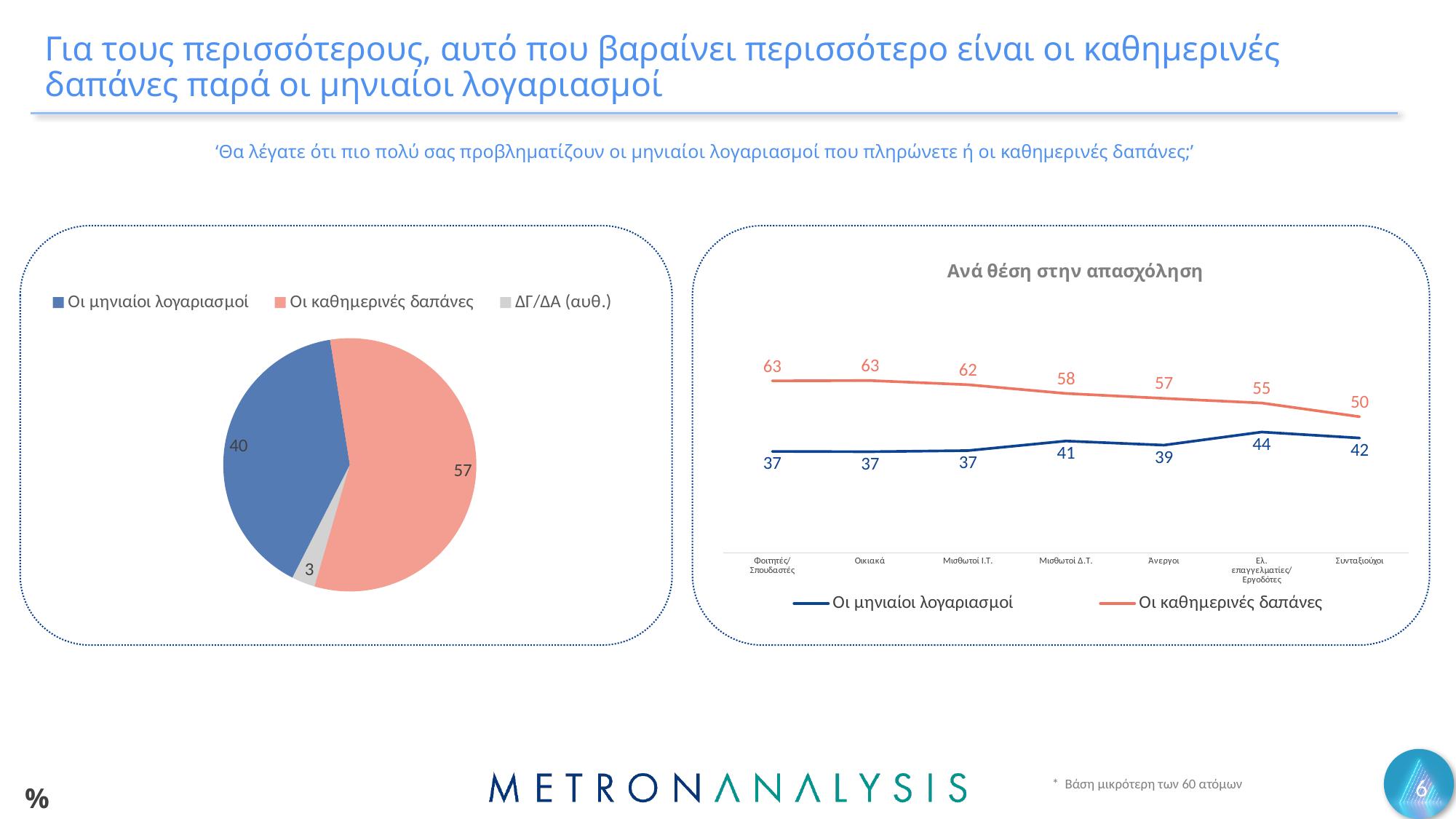
In the chart titled 'Ανά θέση στην απασχόληση', what is the difference between 'Οι καθημερινές δαπάνες' and 'Οι μηνιαίοι λογαριασμοί' for Άνεργοι? 18 In the chart titled 'Ανά θέση στην απασχόληση', what is the value of 'Οι καθημερινές δαπάνες' for Συνταξιούχοι? 50 In the chart titled 'Ανά θέση στην απασχόληση', what is the value of 'Οι μηνιαίοι λογαριασμοί' for Μισθωτοί Δ.Τ.? 41 In the pie chart on the left, which category has the largest slice? Οι καθημερινές δαπάνες In the chart titled 'Ανά θέση στην απασχόληση', which category has the lowest value for 'Οι καθημερινές δαπάνες'? Συνταξιούχοι What kind of chart is the chart titled 'Ανά θέση στην απασχόληση'? line chart In the pie chart on the left, what is the difference between 'Οι καθημερινές δαπάνες' and 'Οι μηνιαίοι λογαριασμοί'? 17 In the chart titled 'Ανά θέση στην απασχόληση', does the 'Οι καθημερινές δαπάνες' line generally rise or fall from left to right? fall In the pie chart on the left, what is the value for 'Οι καθημερινές δαπάνες'? 57 In the pie chart on the left, what is the value for 'ΔΓ/ΔΑ (αυθ.)'? 3 In the pie chart on the left, how many entries does the legend list? 3 In the chart titled 'Ανά θέση στην απασχόληση', which category has the highest value for 'Οι μηνιαίοι λογαριασμοί'? Ελ. επαγγελματίες/Εργοδότες